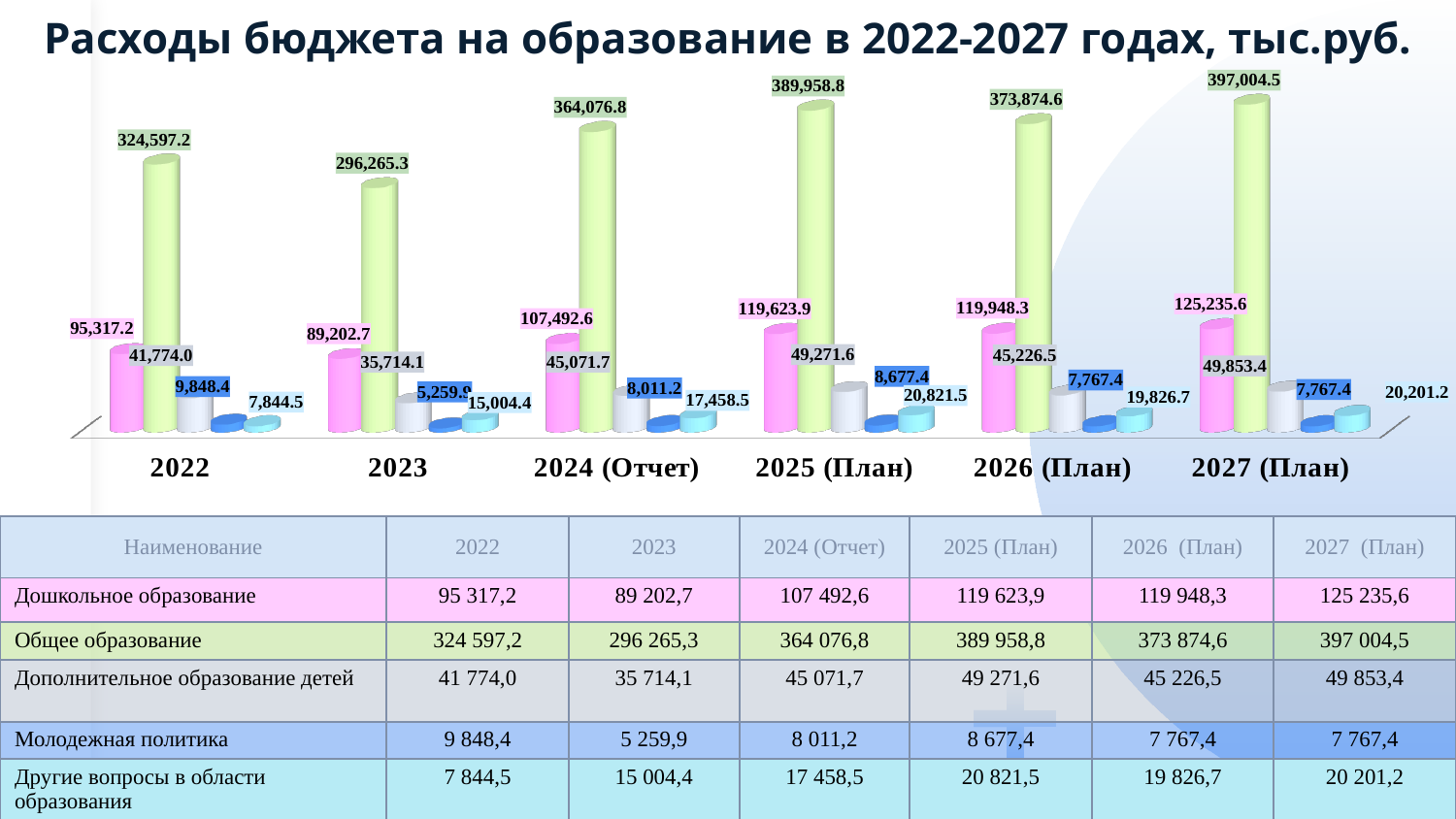
What is the value for Дошкольное образование in 2023? 89,202.7 What is the value for Общее образование in 2027 (План)? 397,004.5 What is the difference between the Молодежная политика values for 2022 and 2023? 4,588.5 What is the difference between the Общее образование values for 2025 (План) and 2024 (Отчет)? 25,882.0 From 2023 to 2027 (План), do the values for Дошкольное образование rise or fall? rise Which is larger: the Дошкольное образование value for 2025 (План) or for 2026 (План)? 2026 (План) In which year is the value for Общее образование the highest? 2027 (План) Which series has the tallest bar in 2024 (Отчет)? Общее образование In which year is the value for Молодежная политика the lowest? 2023 How many years (categories) are shown on the x axis of the chart? 6 What type of chart is shown on the slide? bar chart What is the value for Другие вопросы в области образования in 2025 (План)? 20,821.5